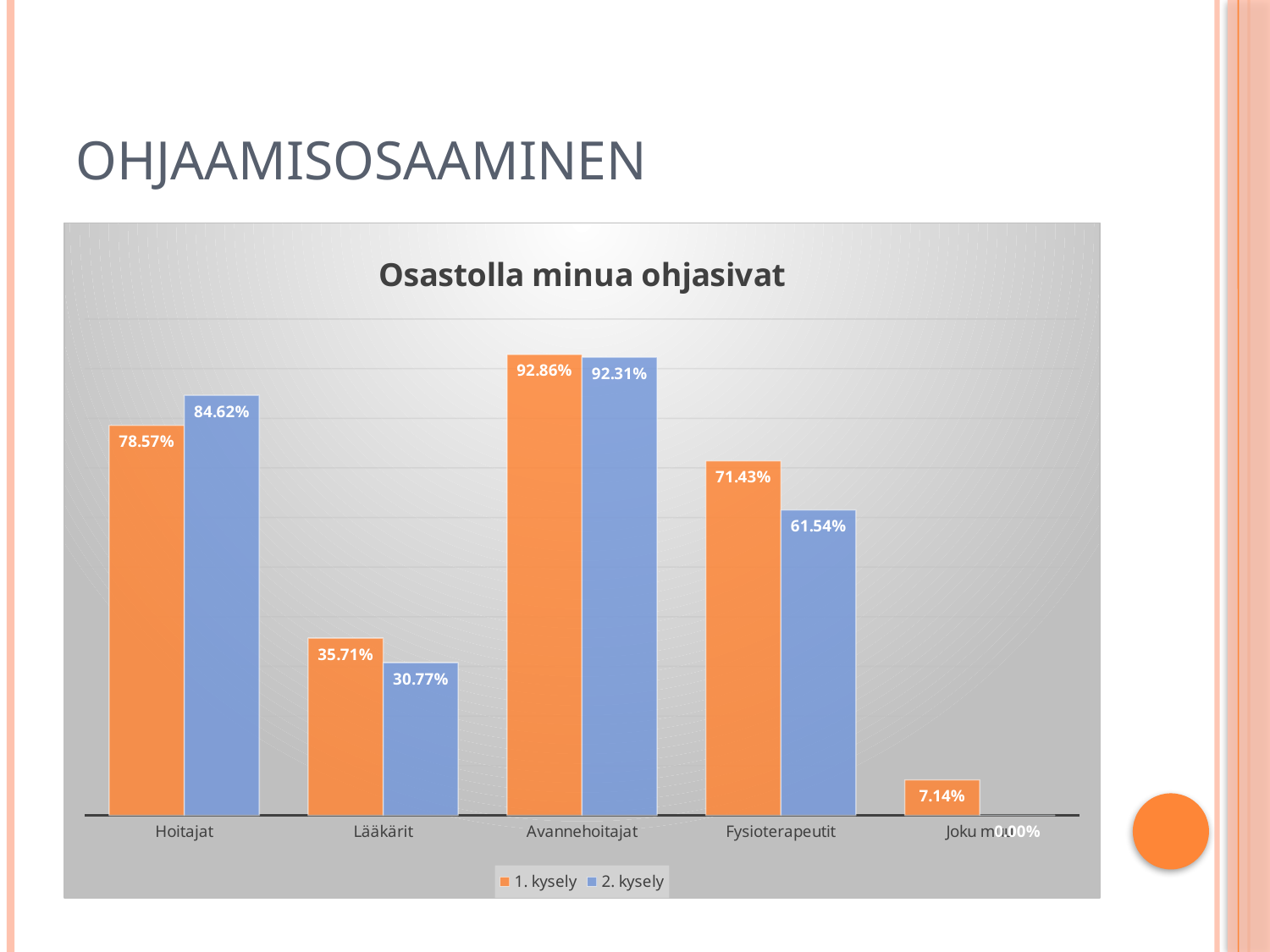
How many categories are shown on the x axis? 5 What is the difference between the 1. kysely and 2. kysely values for Fysioterapeutit? 9.89 percentage points What is the title of the chart? Osastolla minua ohjasivat What is the value for Hoitajat in the 1. kysely series? 78.57% How many series does the legend list? 2 What kind of chart is shown on the slide? Bar chart What is the value for Lääkärit in the 2. kysely series? 30.77% Which category has the lowest value in the 2. kysely series? Joku muu For Hoitajat, which series has the larger value, 1. kysely or 2. kysely? 2. kysely Which category has the highest value in the 1. kysely series? Avannehoitajat Which colour represents the 2. kysely series? Blue What is the value for Fysioterapeutit in the 2. kysely series? 61.54%